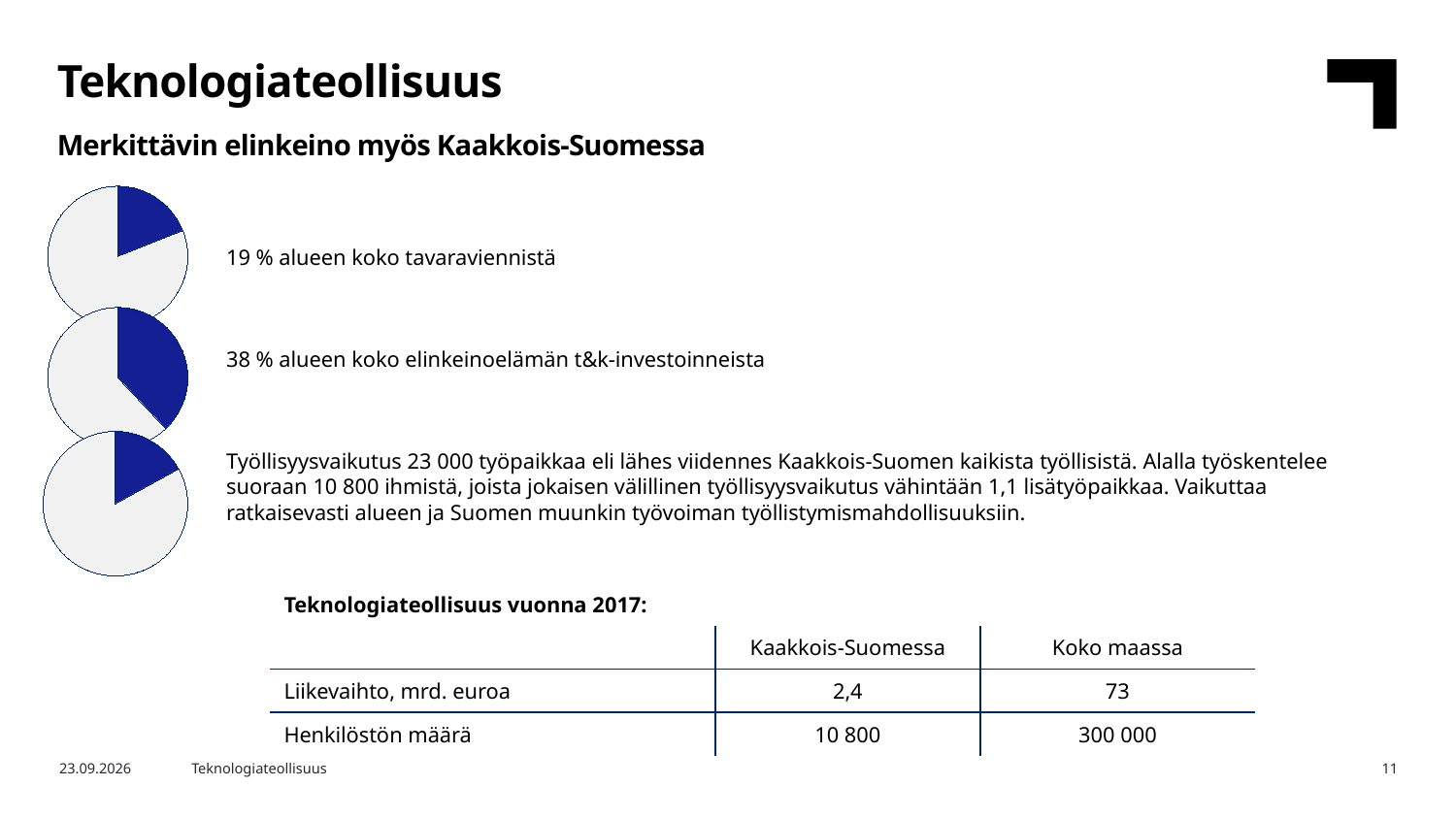
According to the text next to the top pie chart, what share of the region's total goods exports does the blue slice represent? 19 % What colour is used for the highlighted slice in the pie charts? Dark blue What kind of charts are shown on the left side of the slide? Pie charts Which of the three pie charts has the largest blue slice? The middle pie chart (38 %) According to the text next to the middle pie chart, what share of the region's business R&D investments does the blue slice represent? 38 % Is the blue slice of the middle pie chart larger or smaller than the blue slice of the top pie chart? Larger How many slices does each pie chart have? 2 What is the difference between the share shown for the middle pie chart (38 %) and the top pie chart (19 %)? 19 percentage points Is the blue slice of the bottom pie chart greater or less than 50% of the pie? less What colour is the remaining (non-highlighted) part of each pie chart? Light grey How many pie charts are on the slide? 3